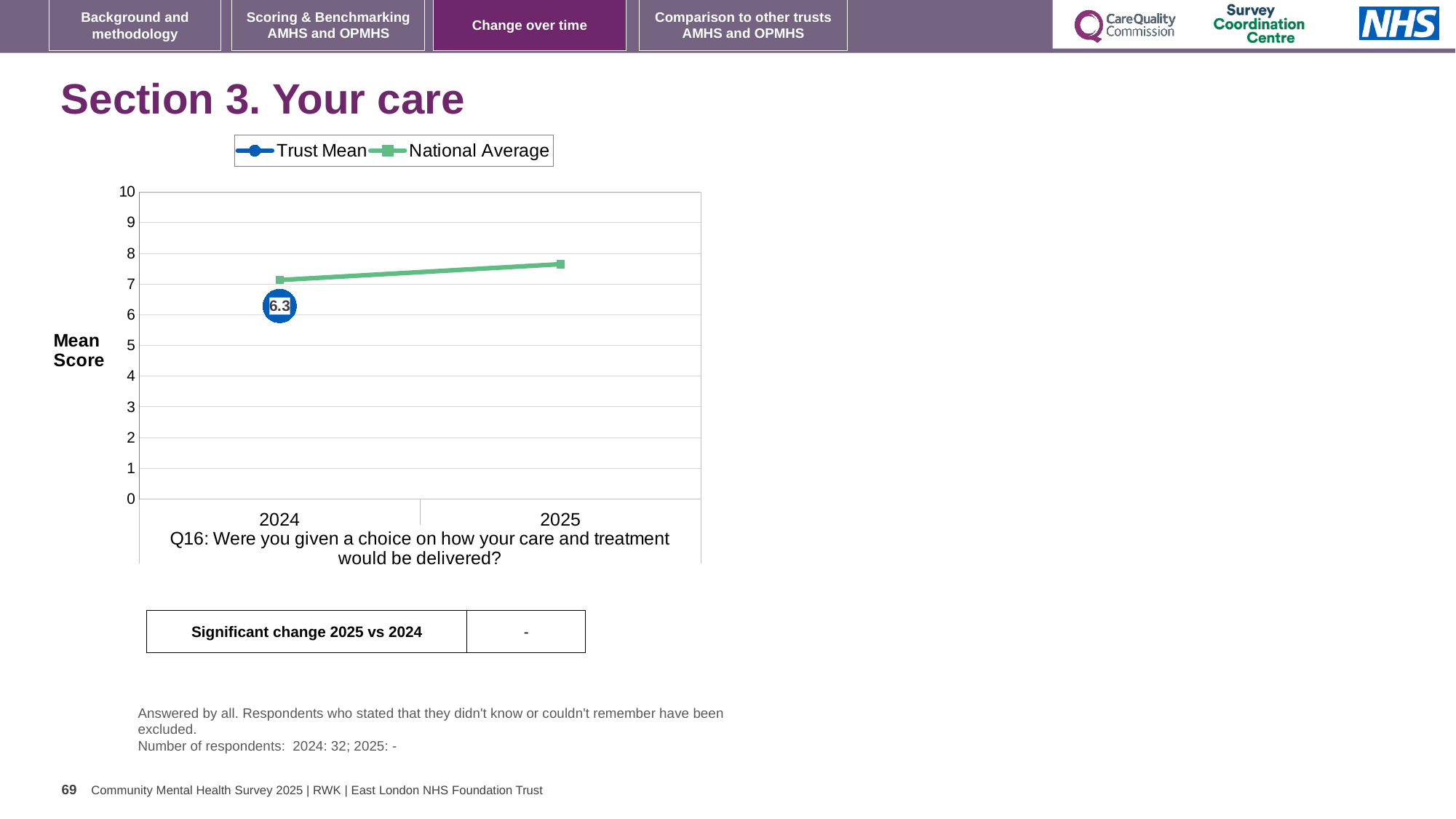
What is the label on the y axis of the chart? Mean Score Is the National Average value for 2024 greater or less than 6? greater How many series does the legend list? 2 What kind of chart is shown on the slide? Line chart Does the National Average rise or fall from 2024 to 2025? Rise Which survey question does the chart relate to? Q16: Were you given a choice on how your care and treatment would be delivered? Is the Trust Mean value for 2024 greater or less than 7? less What is the Trust Mean value for 2024? 6.3 How many years are shown on the x axis? 2 Is the National Average value for 2024 greater or less than 8? less In 2024, which is larger: the Trust Mean or the National Average? National Average